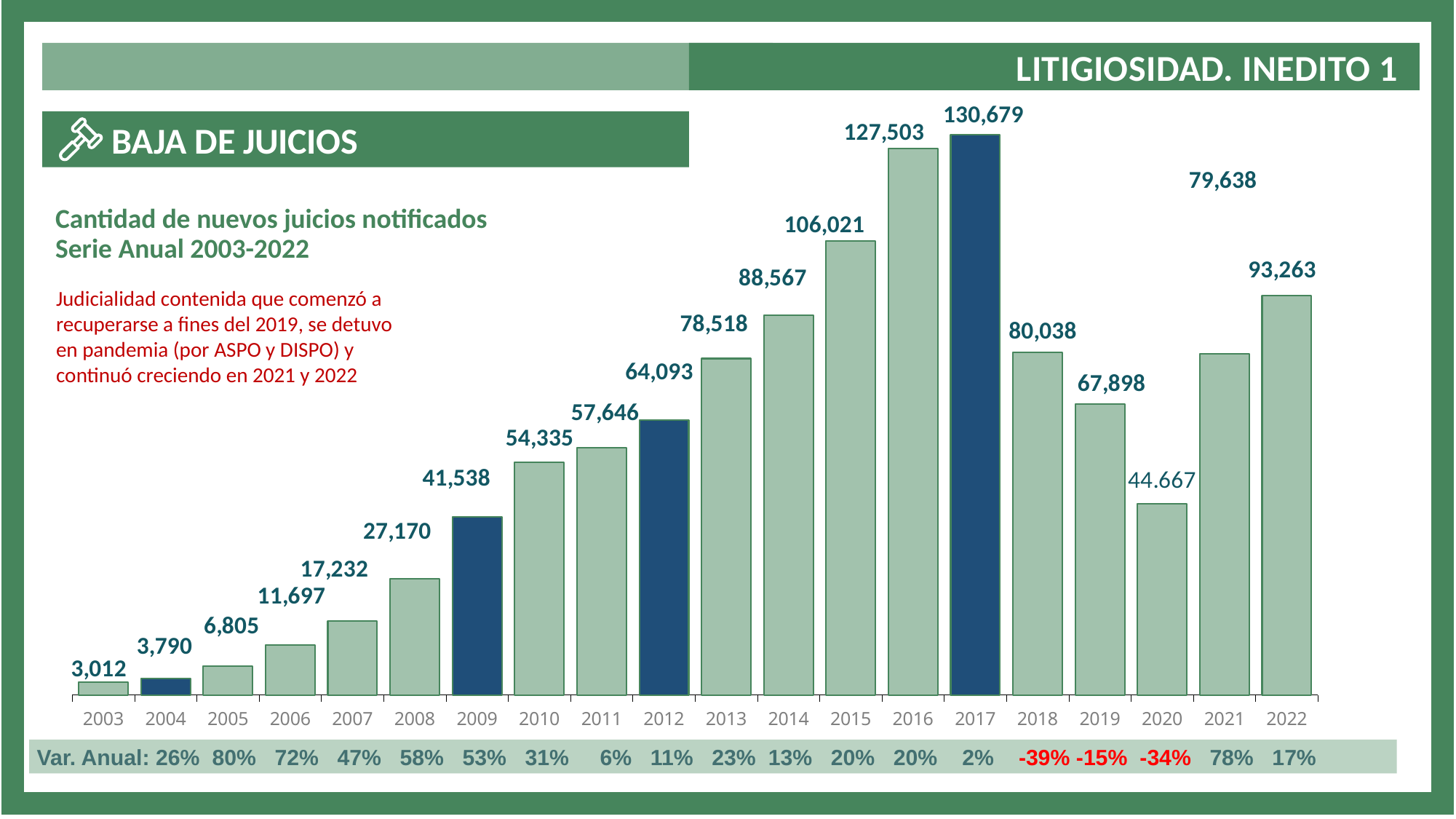
Which is larger, the value for 2018 or the value for 2021? 2018 Do the values rise or fall from 2003 to 2017? Rise What is the value for 2009? 41,538 What is the difference between the values for 2017 and 2016? 3,176 What is the difference between the values for 2022 and 2021? 13,625 What type of chart is shown on the slide? Bar chart How many years (bars) are plotted in the chart? 20 Which year has the lowest value? 2003 What is the value for 2020? 44.667 Which year has the highest value? 2017 What is the value for 2017? 130,679 What is the annual variation (Var. Anual) shown for 2018? -39%